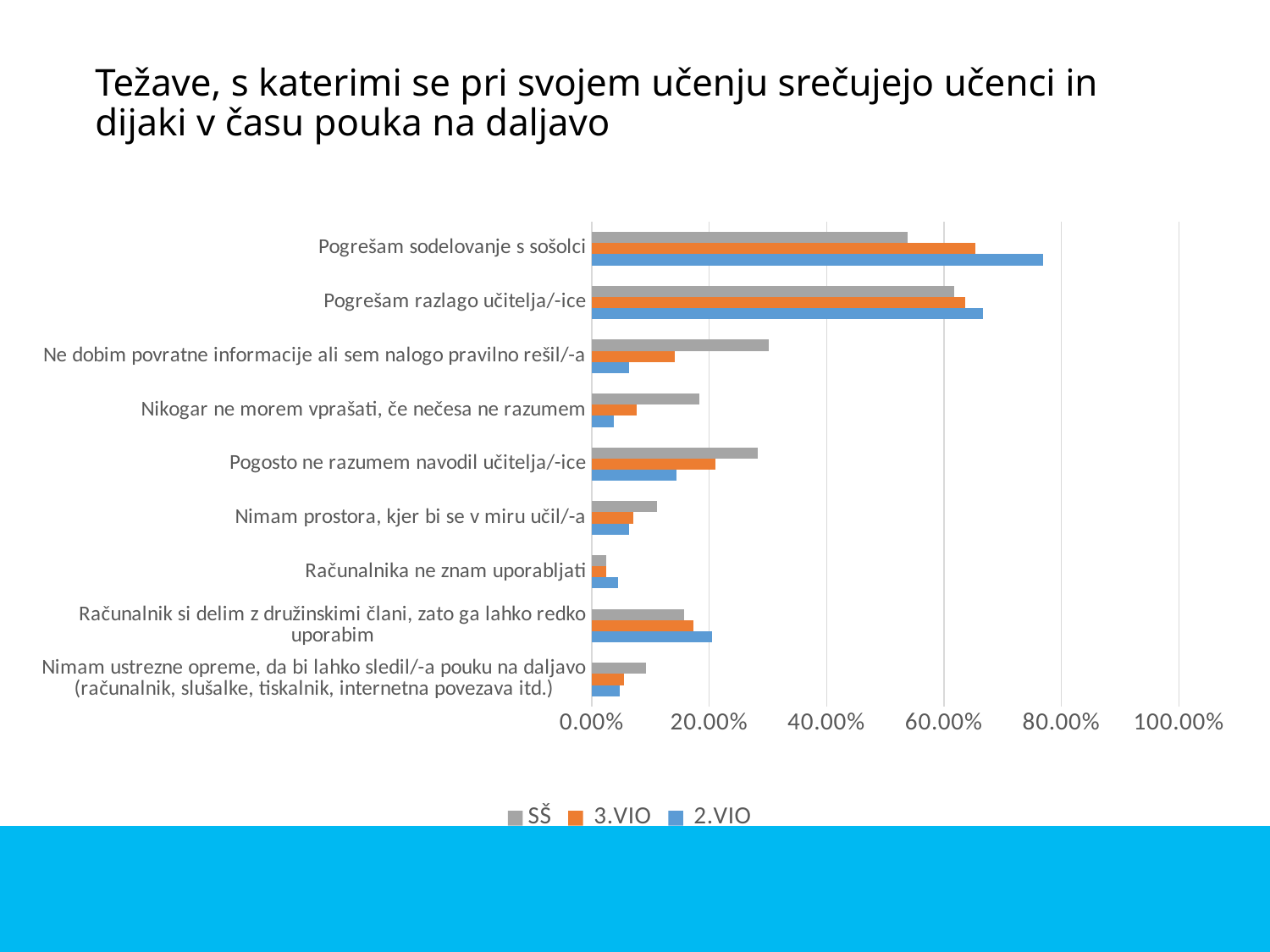
For 'Ne dobim povratne informacije ali sem nalogo pravilno rešil/-a', which series has the larger value: SŠ or 2.VIO? SŠ Which series is shown in orange in the legend? 3.VIO For 'Pogrešam sodelovanje s sošolci', which series has the larger value: SŠ or 2.VIO? 2.VIO Is the 2.VIO value for 'Pogrešam sodelovanje s sošolci' greater or less than 60.00%? greater How many series does the legend list? 3 How many categories are plotted on the chart? 9 Is the 3.VIO value for 'Pogosto ne razumem navodil učitelja/-ice' greater or less than 40.00%? less Which category has the lowest value for the SŠ series? Računalnika ne znam uporabljati Is the SŠ value for 'Ne dobim povratne informacije ali sem nalogo pravilno rešil/-a' greater or less than 40.00%? less What kind of chart is shown on the slide? bar chart Which category has the highest value for the 2.VIO series? Pogrešam sodelovanje s sošolci